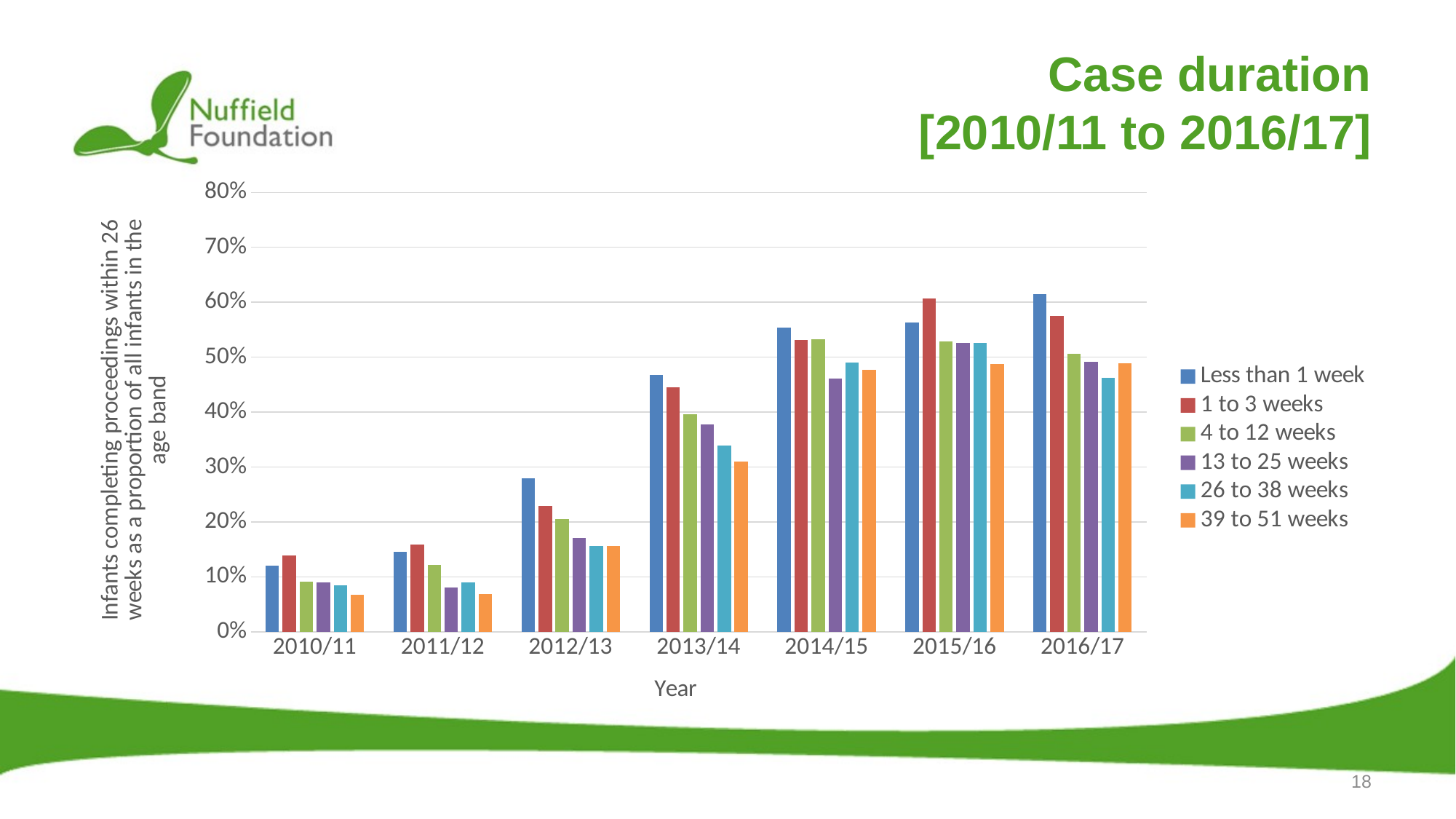
In 2012/13, which is larger: the value for 'Less than 1 week' or for '1 to 3 weeks'? Less than 1 week How many years are shown on the x axis of the chart? 7 What kind of chart is shown on the slide? Bar chart In 2015/16, which age band has the highest value? 1 to 3 weeks Is the value for '39 to 51 weeks' in 2010/11 greater or less than 10%? less Is the value for 'Less than 1 week' in 2013/14 greater or less than 40%? greater Is the value for 'Less than 1 week' in 2016/17 greater or less than 50%? greater How many series does the legend list? 6 Does the value for 'Less than 1 week' generally rise or fall from 2010/11 to 2016/17? Rise In which year is the value for 'Less than 1 week' the highest? 2016/17 In 2013/14, which age band has the lowest value? 39 to 51 weeks What is the title of the x axis of the chart? Year